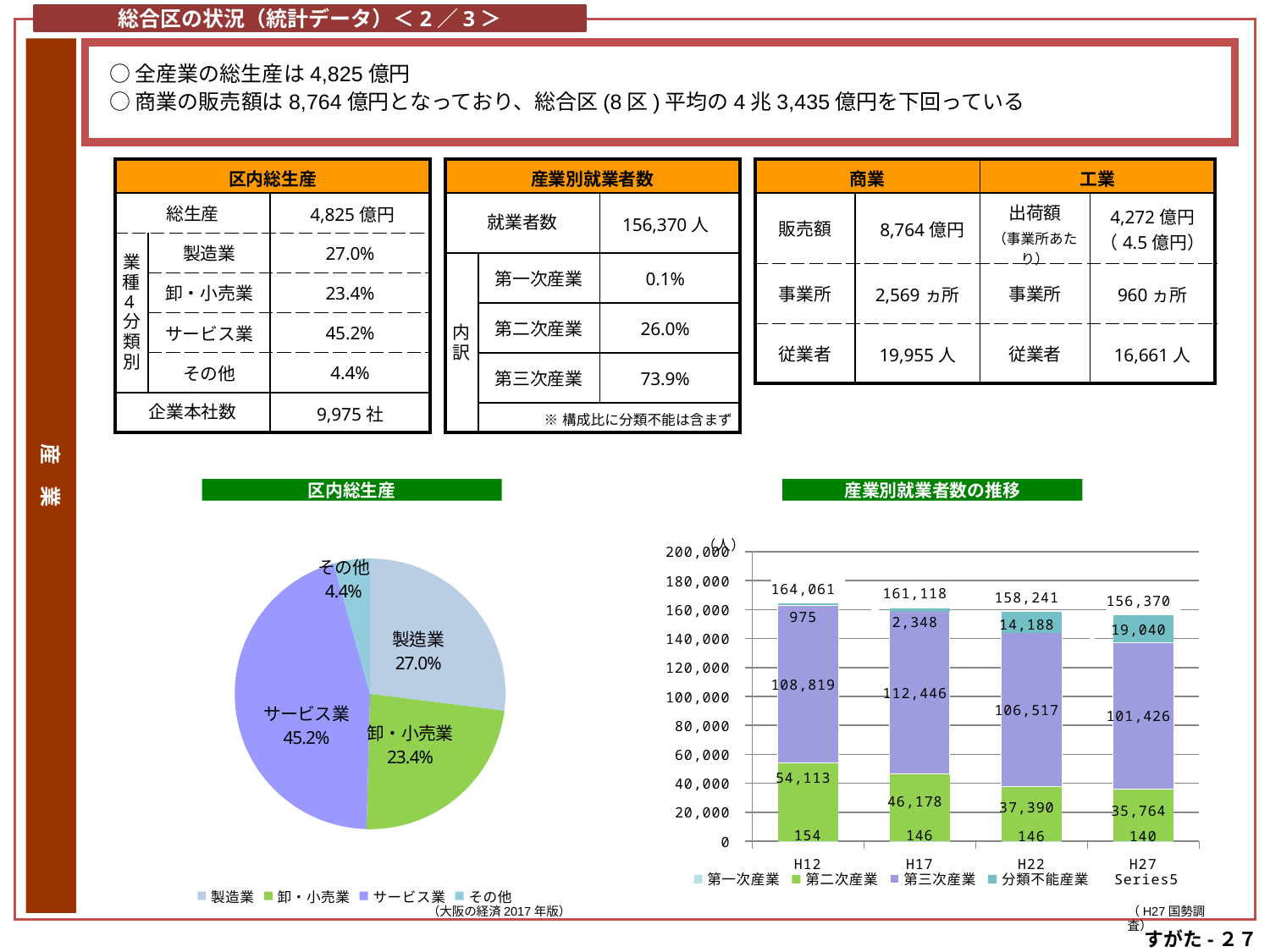
In the 区内総生産 pie chart, which category has the largest share? サービス業 In the 産業別就業者数の推移 chart, what is the value of 分類不能産業 in H27? 19,040 In the 産業別就業者数の推移 chart, how many years are shown on the x axis? 4 In the 産業別就業者数の推移 chart, what is the value of 第三次産業 in H17? 112,446 In the 産業別就業者数の推移 chart, which year has the highest total? H12 In the 産業別就業者数の推移 chart, how do the total values change from H12 to H27? They fall In the 区内総生産 pie chart, what is the difference between the shares of 製造業 and 卸・小売業? 3.6% In the 産業別就業者数の推移 chart, is the value of 第二次産業 in H12 greater or less than 第二次産業 in H27? greater In the 区内総生産 pie chart, which category has the smallest share? その他 What kind of chart is the 区内総生産 chart? pie chart In the 産業別就業者数の推移 chart, what is the total for H22? 158,241 In the 区内総生産 pie chart, what share does サービス業 have? 45.2%